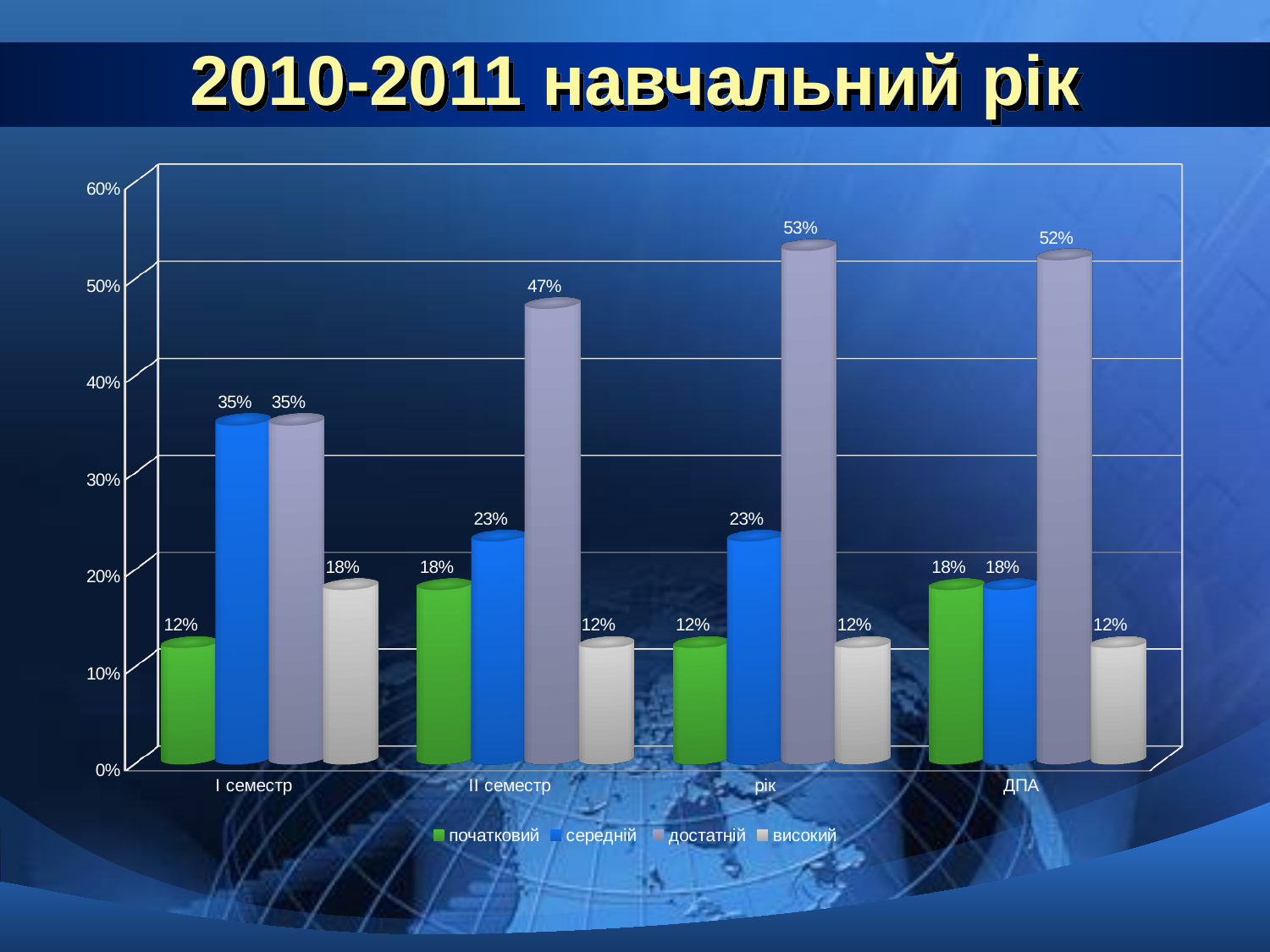
What is the title of the slide? 2010-2011 навчальний рік What is the value for середній in І семестр? 35% What is the value for початковий in ДПА? 18% How many series does the legend list? 4 What is the value for високий in ІІ семестр? 12% What kind of chart is shown on the slide? bar chart In which category is the достатній series highest? рік In which category is the достатній series lowest? І семестр What is the value for достатній in the рік category? 53% Which is larger in І семестр: початковий or високий? високий What is the difference between достатній and середній in ІІ семестр? 24% How many categories are shown on the x axis? 4